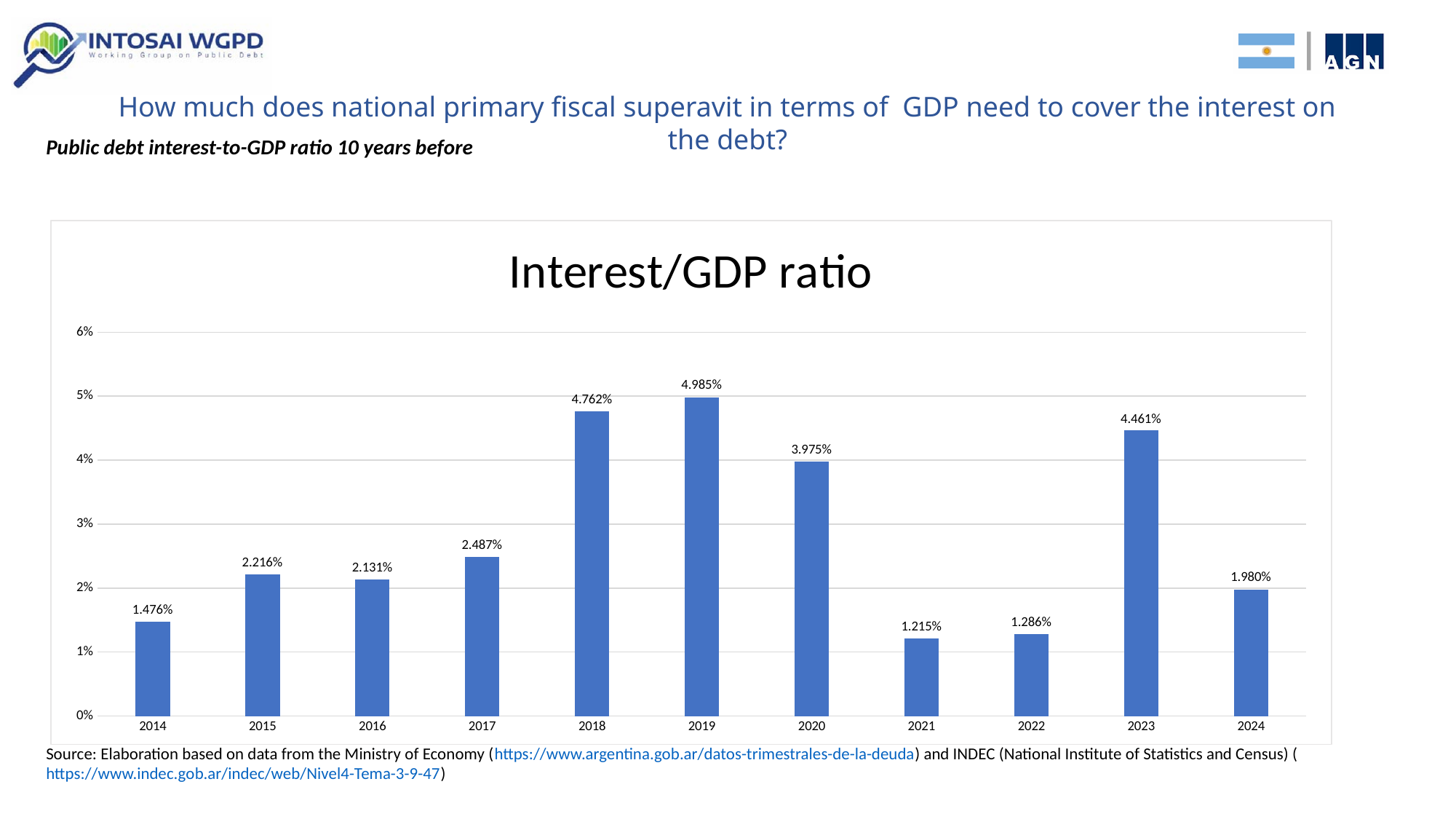
What is the Interest/GDP ratio for 2019? 4.985% What is the title of the chart on the slide? Interest/GDP ratio Which year has the lowest Interest/GDP ratio? 2021 What is the Interest/GDP ratio for 2014? 1.476% What is the difference between the Interest/GDP ratio in 2019 and in 2020? 1.010% Is the Interest/GDP ratio for 2017 greater or less than 2%? greater What is the Interest/GDP ratio for 2023? 4.461% What kind of chart is used to show the Interest/GDP ratio? Bar chart How many years are shown on the x axis of the Interest/GDP ratio chart? 11 Which year has the highest Interest/GDP ratio? 2019 Which year has a higher Interest/GDP ratio, 2018 or 2023? 2018 Does the Interest/GDP ratio rise or fall from 2020 to 2021? Fall